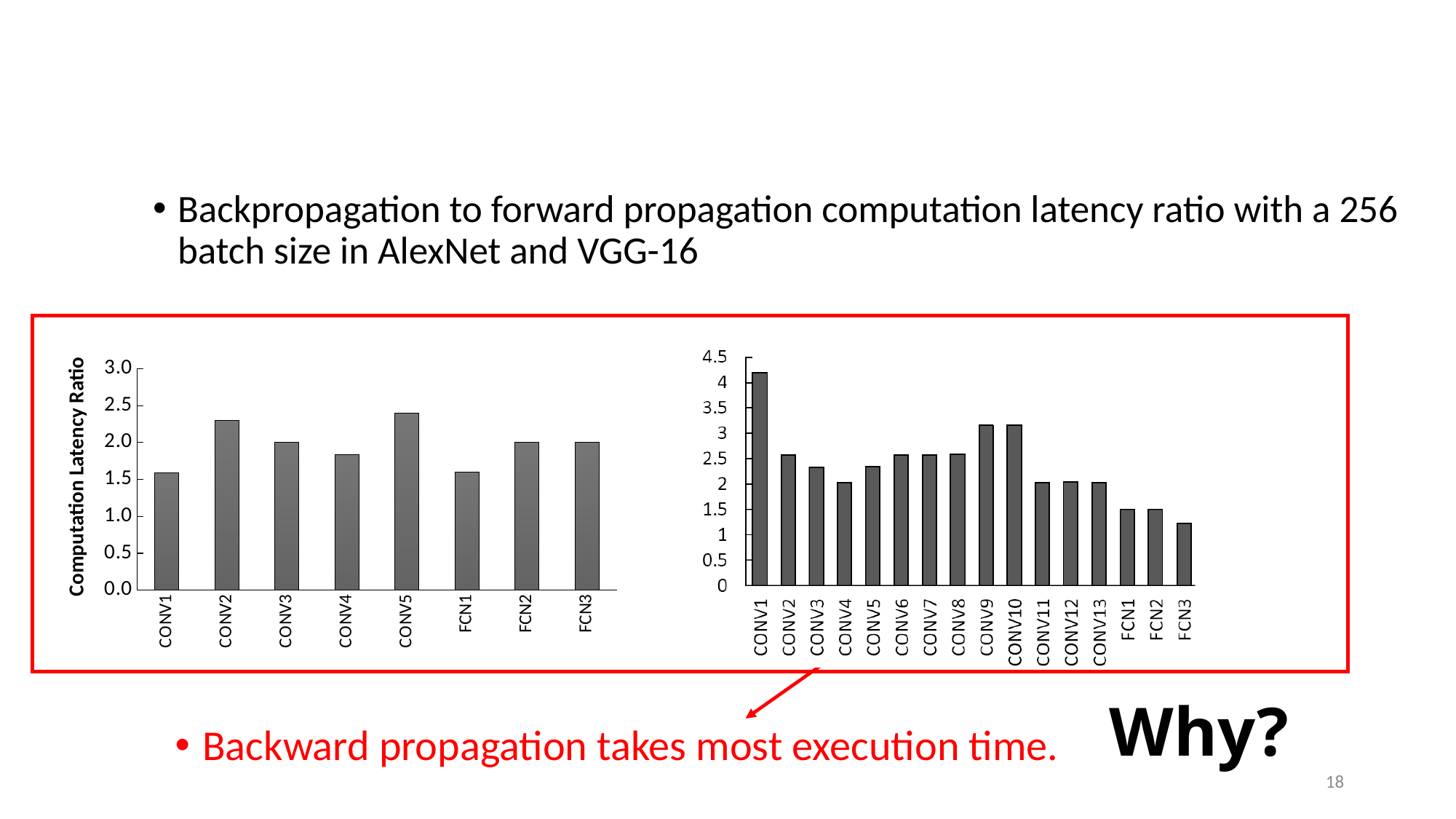
How many categories are shown on the x axis of the left chart? 8 What is the y-axis label of the left chart? Computation Latency Ratio In the right chart, is the value for FCN3 greater or less than 1.5? less In the right chart, which is larger, the value for CONV1 or the value for CONV2? CONV1 In the left chart, which is larger, the value for CONV2 or the value for CONV4? CONV2 In the right chart, which category has the highest value? CONV1 In the right chart, is the value for CONV9 greater or less than 3? greater In the right chart, is the value for CONV1 greater or less than 4? greater In the right chart, which category has the lowest value? FCN3 How many categories are shown on the x axis of the right chart? 16 What type of chart is the left chart on the slide? bar chart